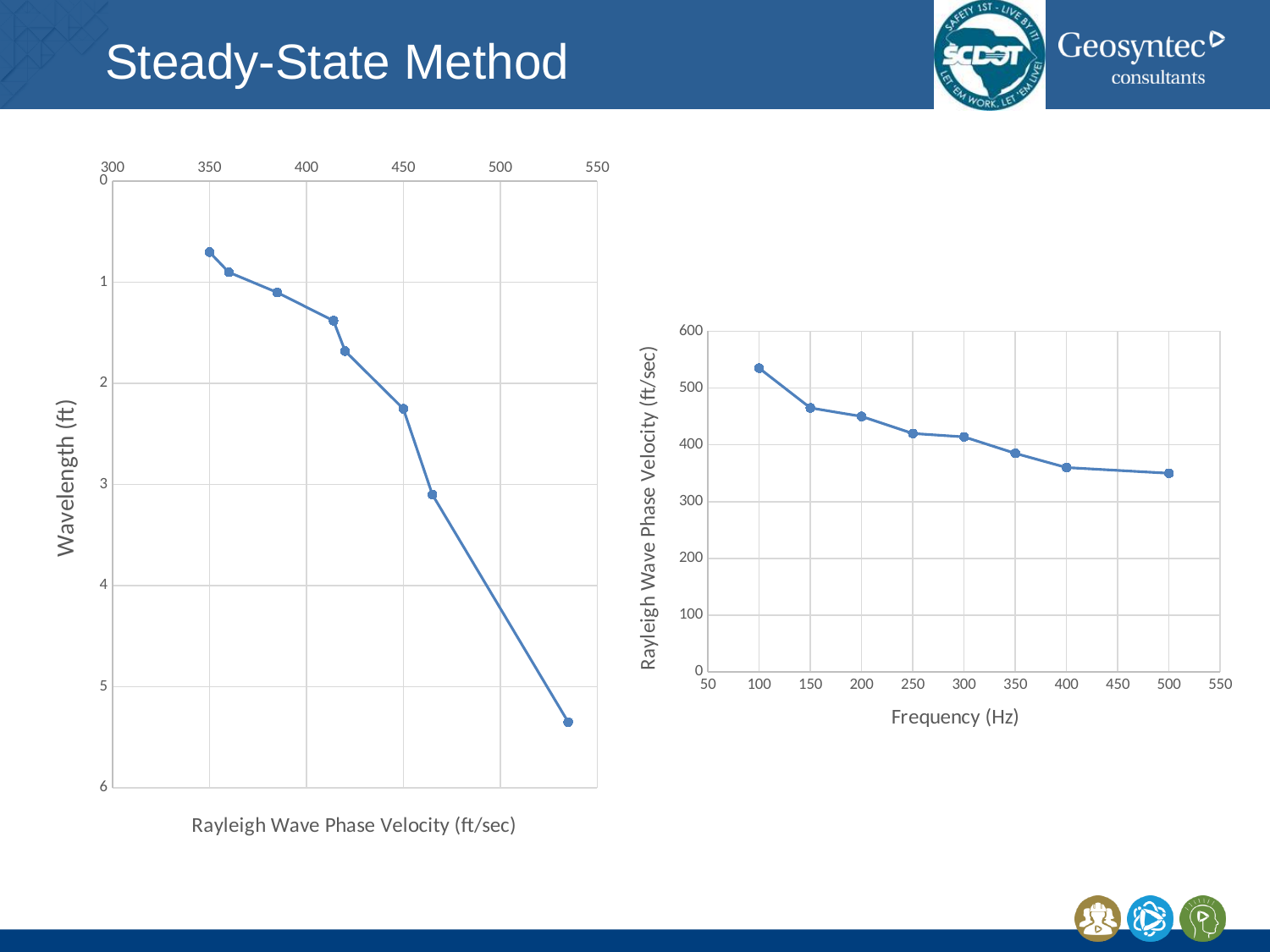
In the chart on the right, is the phase velocity at 500 Hz greater or less than 400 ft/sec? less In the chart on the left, how many data points are plotted? 8 In the chart on the right, how many data points are plotted? 8 In the chart on the right, at which frequency is the Rayleigh wave phase velocity highest? 100 Hz What is the y-axis title of the chart on the left? Wavelength (ft) In the chart on the right, is the phase velocity at 150 Hz greater or less than 400 ft/sec? greater What type of chart is the chart on the left (Wavelength vs Rayleigh Wave Phase Velocity)? line chart In the chart on the left, is the wavelength at the point with the highest phase velocity greater or less than 5 ft? greater What type of chart is the chart on the right (Rayleigh Wave Phase Velocity vs Frequency)? line chart What is the x-axis title of the chart on the right? Frequency (Hz) In the chart on the right, does the Rayleigh wave phase velocity rise or fall as frequency increases? fall